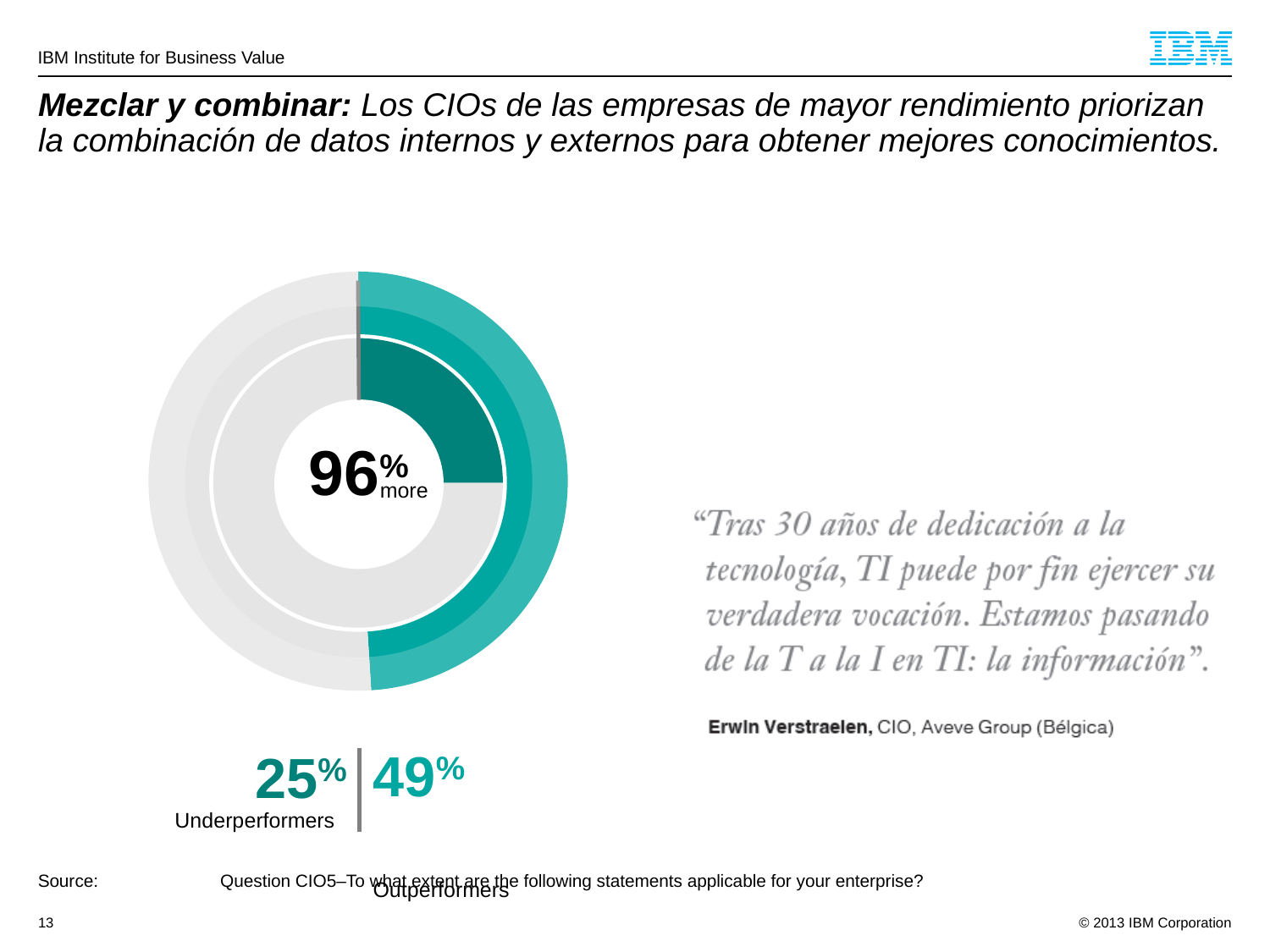
Which group has the lowest percentage shown? Underperformers What percentage is shown for Underperformers? 25% What figure is printed in the centre of the donut chart? 96% more How many groups are compared in the chart? 2 Is the value for Underperformers greater or less than 30%? less Is the value for Outperformers greater or less than 50%? less What kind of chart is shown on the slide? Donut chart Who is quoted on the slide next to the chart? Erwin Verstraelen, CIO, Aveve Group (Bélgica) What percentage is shown for Outperformers? 49% What is the difference in percentage points between Outperformers and Underperformers? 24 Which ring of the donut chart, inner or outer, represents Outperformers? Outer Which group has the higher percentage, Underperformers or Outperformers? Outperformers